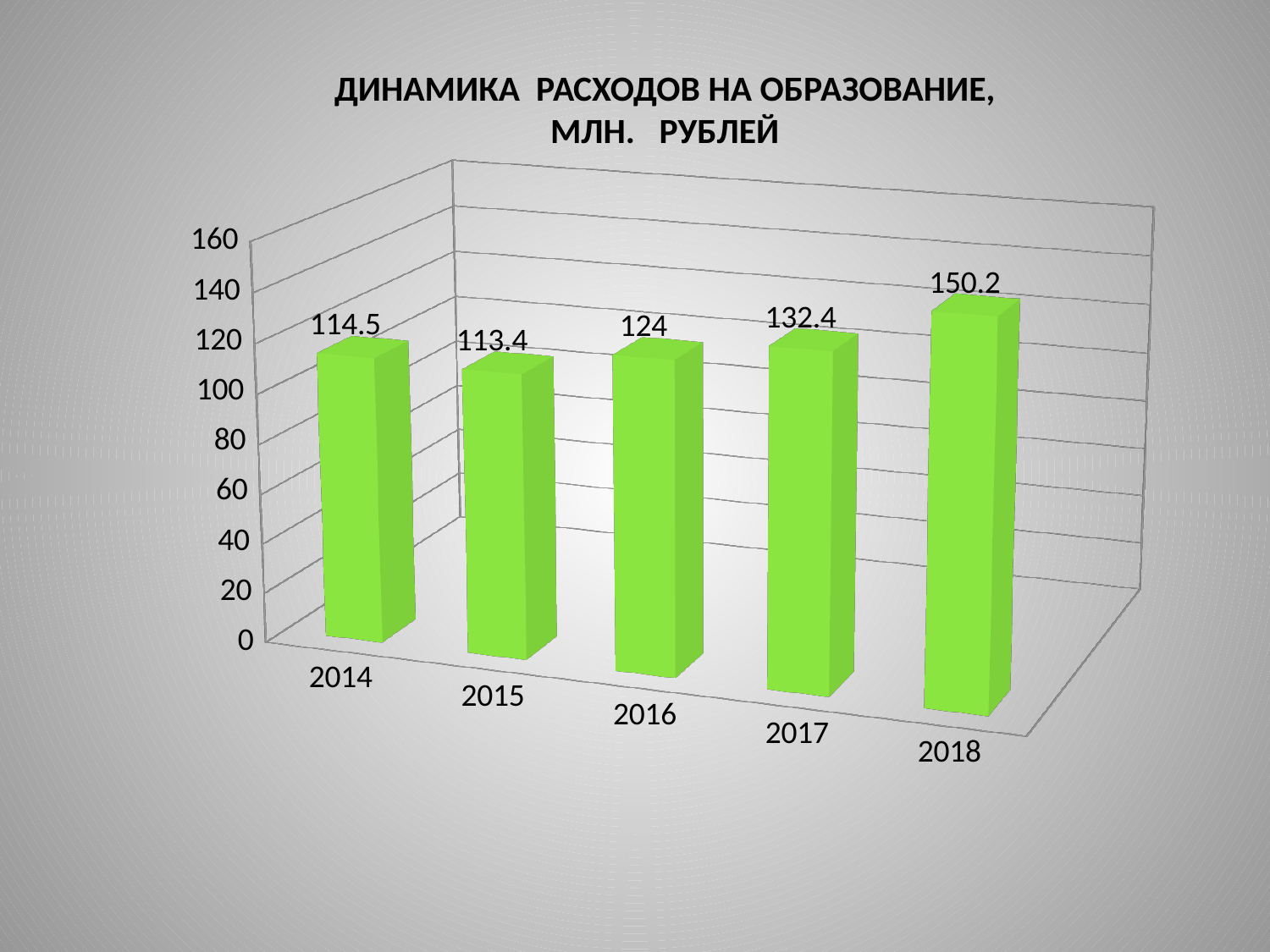
What is the difference between the values for 2016 and 2015? 10.6 Which year has the lowest value? 2015 Which is larger, the value for 2014 or the value for 2015? 2014 What kind of chart is shown on the slide? bar chart Which year has the highest value? 2018 What is the value for 2014? 114.5 What is the value for 2016? 124 What is the value for 2018? 150.2 What is the title of the chart? ДИНАМИКА РАСХОДОВ НА ОБРАЗОВАНИЕ, МЛН. РУБЛЕЙ What is the difference between the values for 2018 and 2017? 17.8 How many years are shown on the chart? 5 Is the value for 2017 greater or less than 120? greater